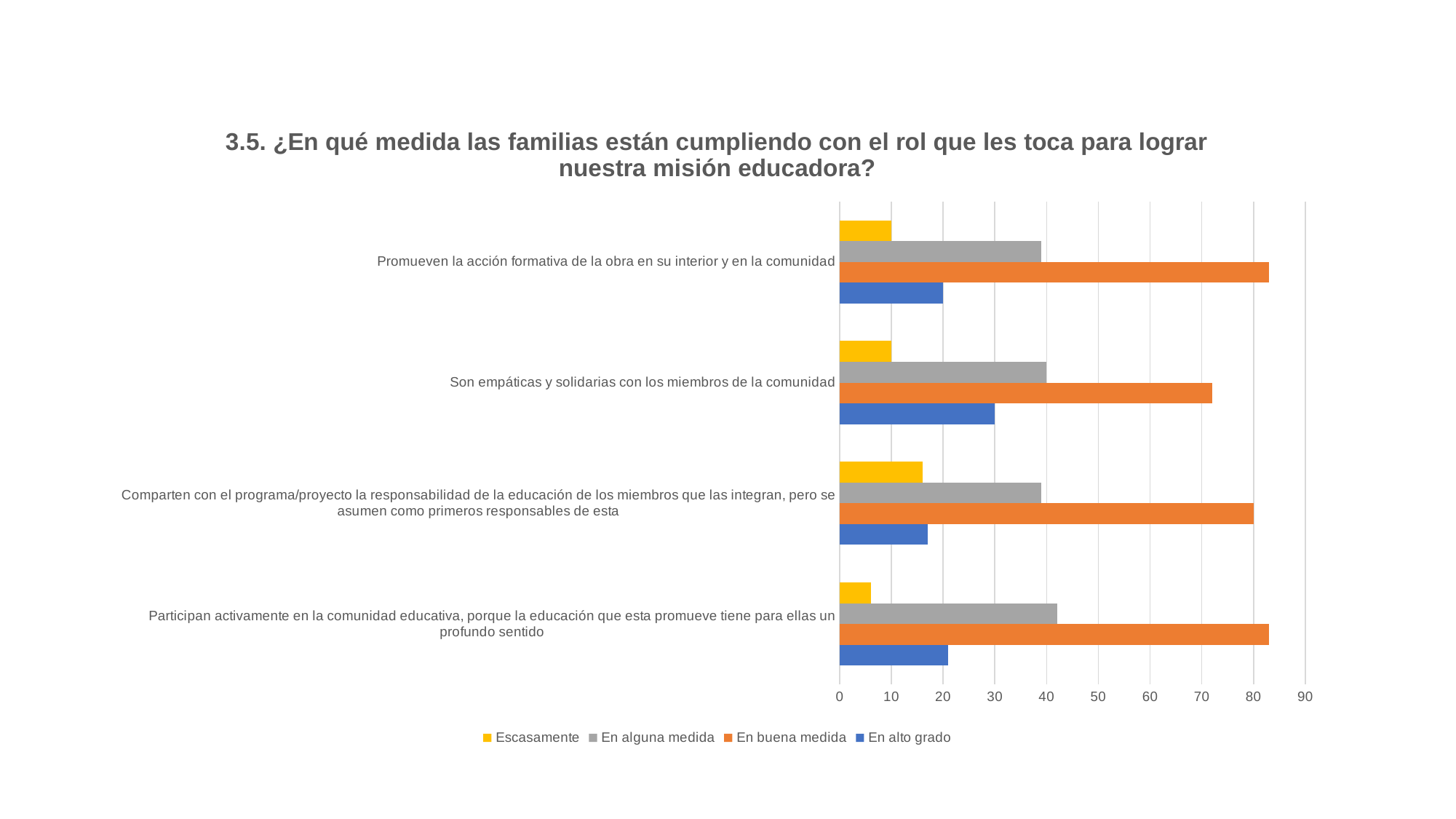
Which series has the lowest value for 'Son empáticas y solidarias con los miembros de la comunidad'? Escasamente What is the value of 'En buena medida' for 'Comparten con el programa/proyecto la responsabilidad de la educación de los miembros que las integran, pero se asumen como primeros responsables de esta'? 80 How many categories are plotted on the chart? 4 What kind of chart is shown on the slide? bar chart What is the value of 'En alto grado' for 'Son empáticas y solidarias con los miembros de la comunidad'? 30 For 'Comparten con el programa/proyecto la responsabilidad de la educación de los miembros que las integran, pero se asumen como primeros responsables de esta', which is larger: 'En alguna medida' or 'En alto grado'? En alguna medida Is the value of 'En buena medida' for 'Promueven la acción formativa de la obra en su interior y en la comunidad' greater or less than 80? greater Which series has the highest value for 'Participan activamente en la comunidad educativa, porque la educación que esta promueve tiene para ellas un profundo sentido'? En buena medida Is the value of 'Escasamente' for 'Participan activamente en la comunidad educativa, porque la educación que esta promueve tiene para ellas un profundo sentido' greater or less than 10? less How many series does the legend list? 4 Which series is represented by the orange bars? En buena medida Is the value of 'En buena medida' for 'Son empáticas y solidarias con los miembros de la comunidad' greater or less than 70? greater